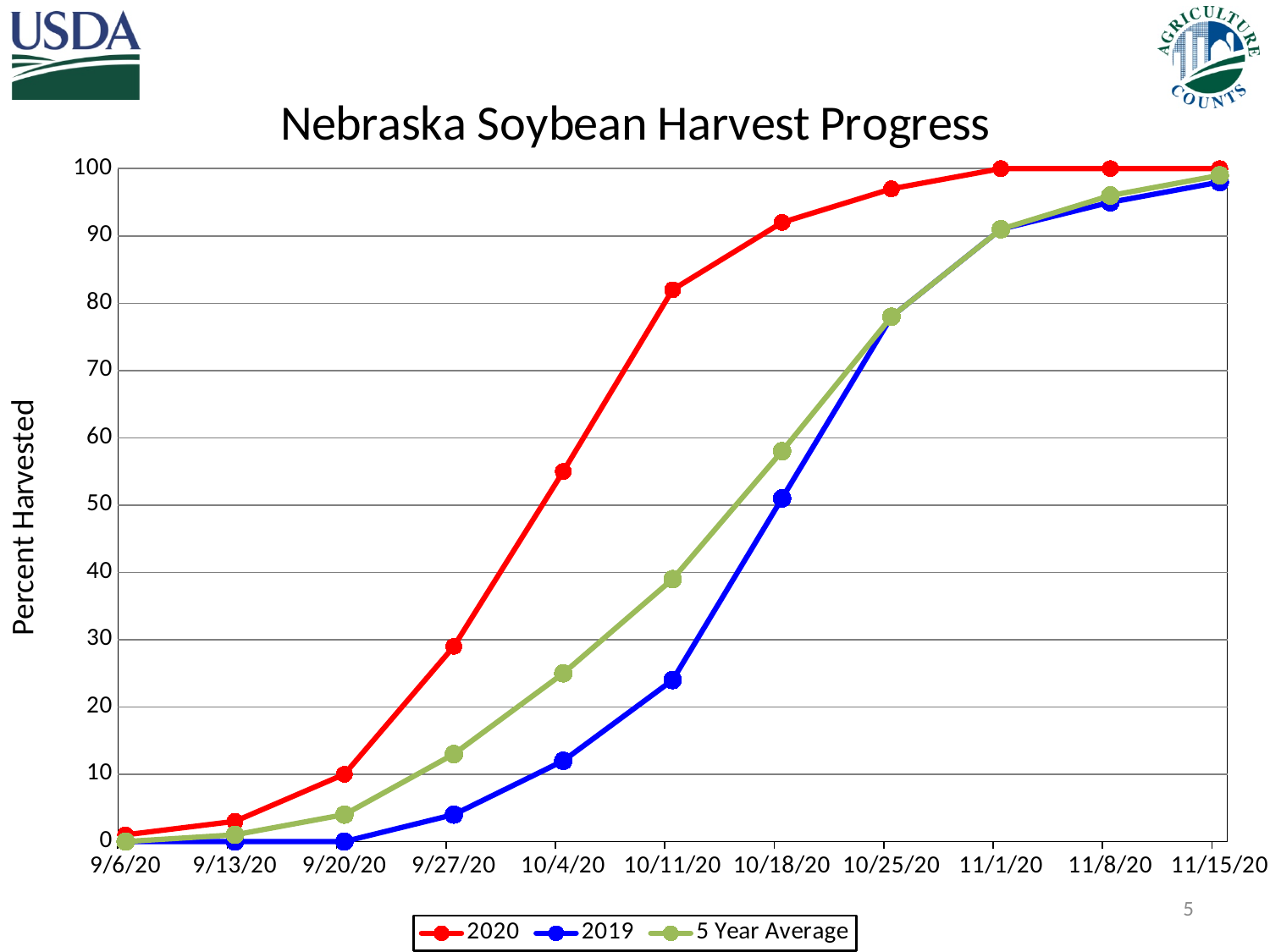
What kind of chart is shown on the slide? Line chart How many series does the legend list? 3 What is the value for 2020 on 11/1/20? 100 Which series has the highest value on 10/4/20? 2020 Is the value for the 5 Year Average on 10/18/20 greater or less than 50? greater Which series has the higher value on 10/11/20, 2020 or 2019? 2020 Is the value for 2019 on 10/25/20 greater or less than 80? less Do the values for 2020 rise or fall from 9/6/20 to 11/15/20? Rise How many dates are plotted along the x axis? 11 What is the title of the chart? Nebraska Soybean Harvest Progress What is the value for 2019 on 9/20/20? 0 Is the value for 2020 on 10/11/20 greater or less than 80? greater